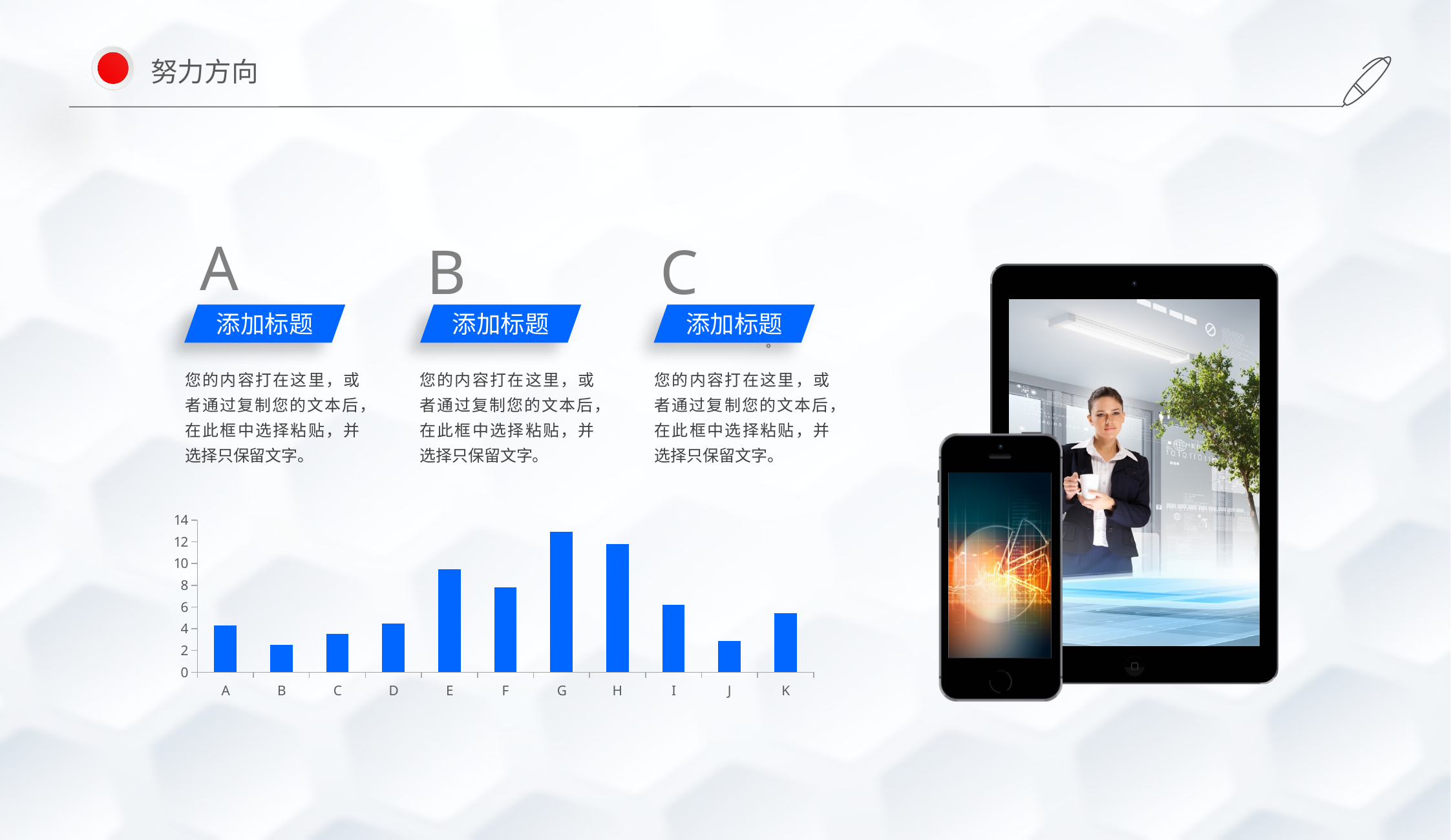
Which category has the highest bar in the chart? G What kind of chart is shown on the slide? bar chart Is the value for G greater or less than 12? greater Is the value for B greater or less than 4? less How many categories are shown on the x axis of the bar chart? 11 Which is larger, the value for E or the value for F? E Is the value for K greater or less than 4? greater Which is larger, the value for G or the value for H? G What is the highest value shown on the y axis of the chart? 14